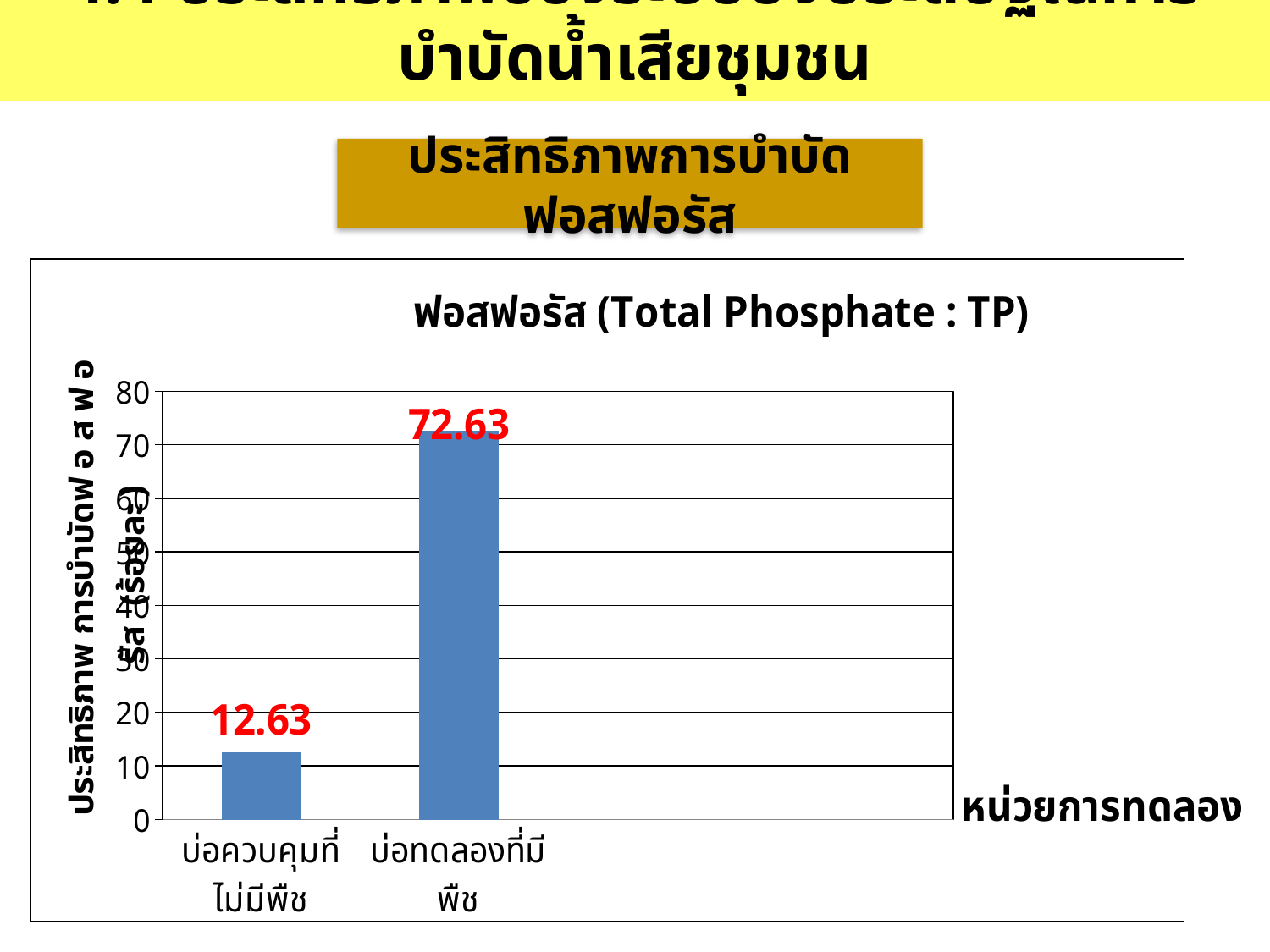
Which category has the highest value? บ่อทดลองที่มีพืช How many categories are shown on the x axis? 2 What is the maximum value shown on the y axis? 80 What is the value for บ่อทดลองที่มีพืช? 72.63 Which is larger, the value for บ่อควบคุมที่ไม่มีพืช or the value for บ่อทดลองที่มีพืช? บ่อทดลองที่มีพืช What is the title of the chart? ฟอสฟอรัส (Total Phosphate : TP) Is the value for บ่อควบคุมที่ไม่มีพืช greater or less than 20? less Is the value for บ่อทดลองที่มีพืช greater or less than 70? greater What is the difference between the values for บ่อทดลองที่มีพืช and บ่อควบคุมที่ไม่มีพืช? 60 What kind of chart is shown? bar chart What is the value for บ่อควบคุมที่ไม่มีพืช? 12.63 Which category has the lowest value? บ่อควบคุมที่ไม่มีพืช